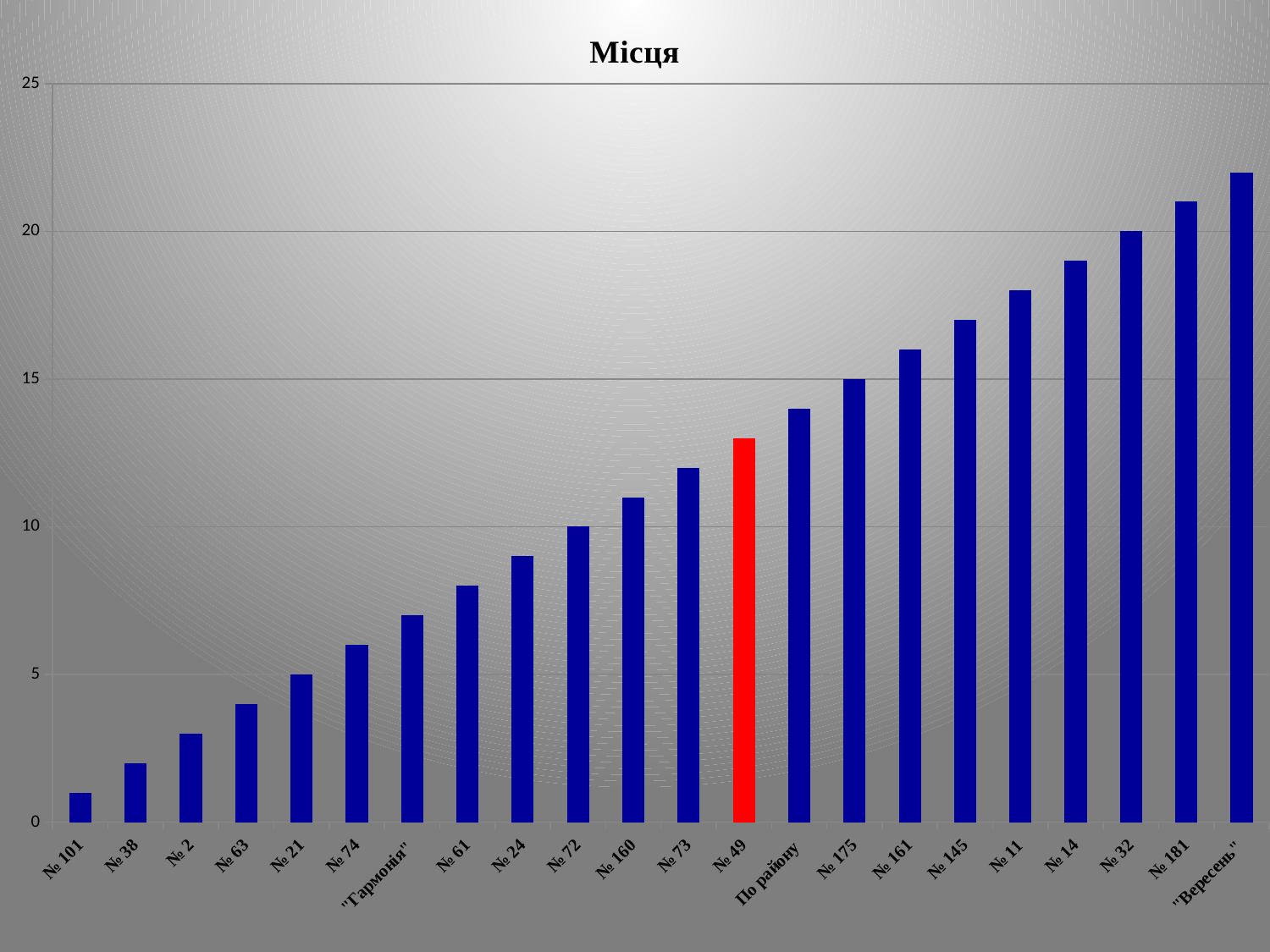
Which bar is coloured red instead of blue? № 49 What is the title of the chart? Місця What is the value for № 21? 5 Is the value for По району greater or less than 15? less Which category has the highest bar? "Вересень" Which category has the lowest bar? № 101 What is the value for № 32? 20 Do the bar values rise or fall from left to right along the x axis? rise How many categories are plotted on the x axis? 22 What is the value for № 72? 10 What kind of chart is shown on the slide? bar chart Which is larger, the value for № 181 or the value for № 145? № 181